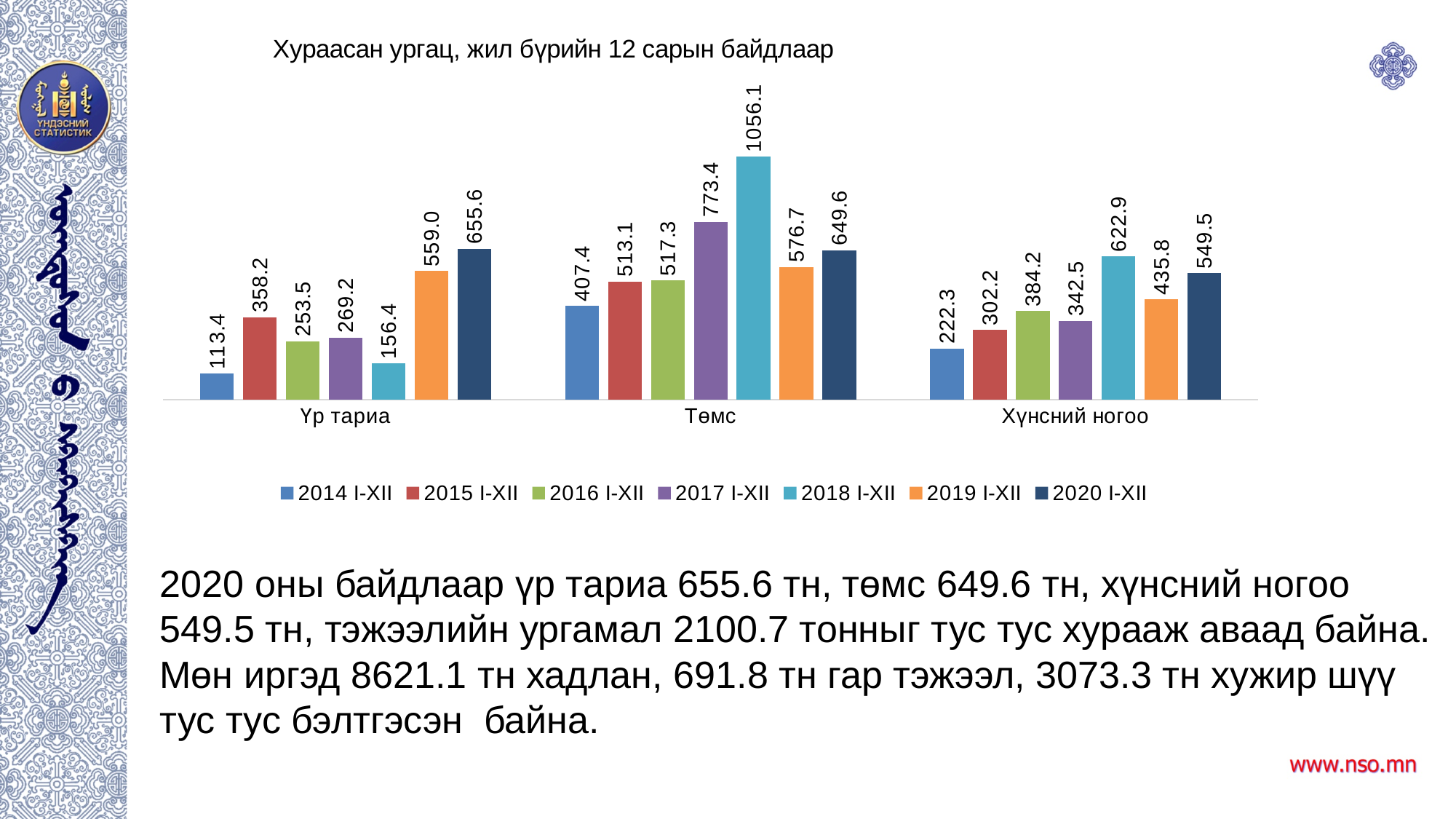
What is the difference between the 2020 I-XII and 2019 I-XII values for Үр тариа? 96.6 What is the title of the chart? Хураасан ургац, жил бүрийн 12 сарын байдлаар Which category has the highest value in the 2018 I-XII series? Төмс How many series does the legend list? 7 Which series has the highest value for Үр тариа? 2020 I-XII What is the value for Хүнсний ногоо in the 2019 I-XII series? 435.8 Which series has the lowest value for Хүнсний ногоо? 2014 I-XII What is the value for Үр тариа in the 2014 I-XII series? 113.4 What type of chart is shown on the slide? bar chart How many categories are shown on the x axis? 3 What is the value for Төмс in the 2018 I-XII series? 1056.1 Which is larger for the 2017 I-XII series: Төмс or Хүнсний ногоо? Төмс